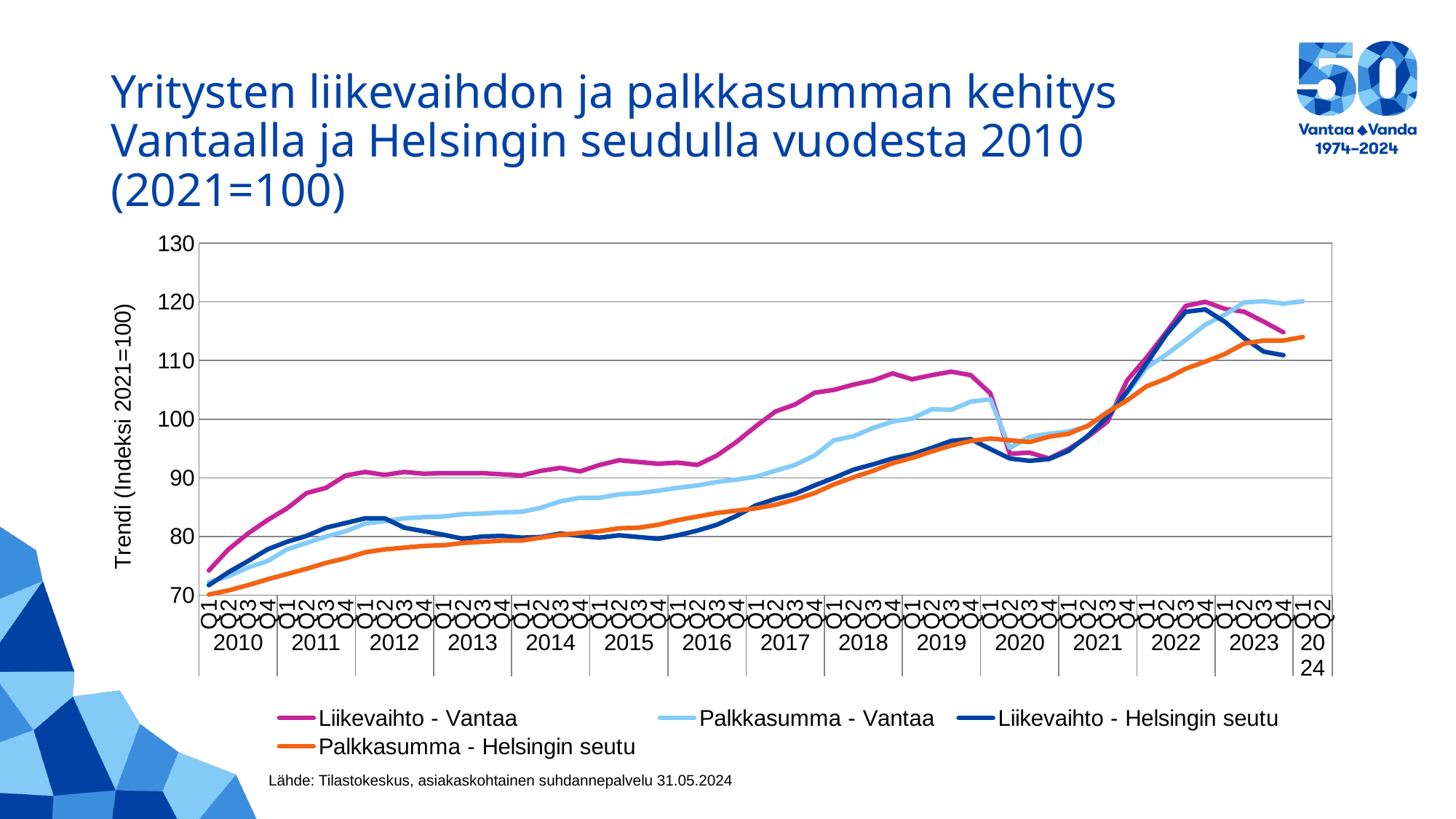
What is the label of the vertical axis? Trendi (Indeksi 2021=100) Is the value for Liikevaihto - Vantaa in Q4 2019 greater or less than 100? greater Which series are listed in the legend? Liikevaihto - Vantaa, Palkkasumma - Vantaa, Liikevaihto - Helsingin seutu, Palkkasumma - Helsingin seutu Is the value for Liikevaihto - Vantaa in Q1 2010 greater or less than 80? less In Q1 2010, which is higher: Liikevaihto - Vantaa or Palkkasumma - Helsingin seutu? Liikevaihto - Vantaa What kind of chart is shown on the slide? Line chart How many series does the legend list? 4 In Q3 2022, which is higher: Liikevaihto - Vantaa or Palkkasumma - Helsingin seutu? Liikevaihto - Vantaa Is the value for Palkkasumma - Helsingin seutu in Q1 2010 greater or less than 80? less Does the Palkkasumma - Helsingin seutu series generally rise or fall from 2010 to 2023? rise